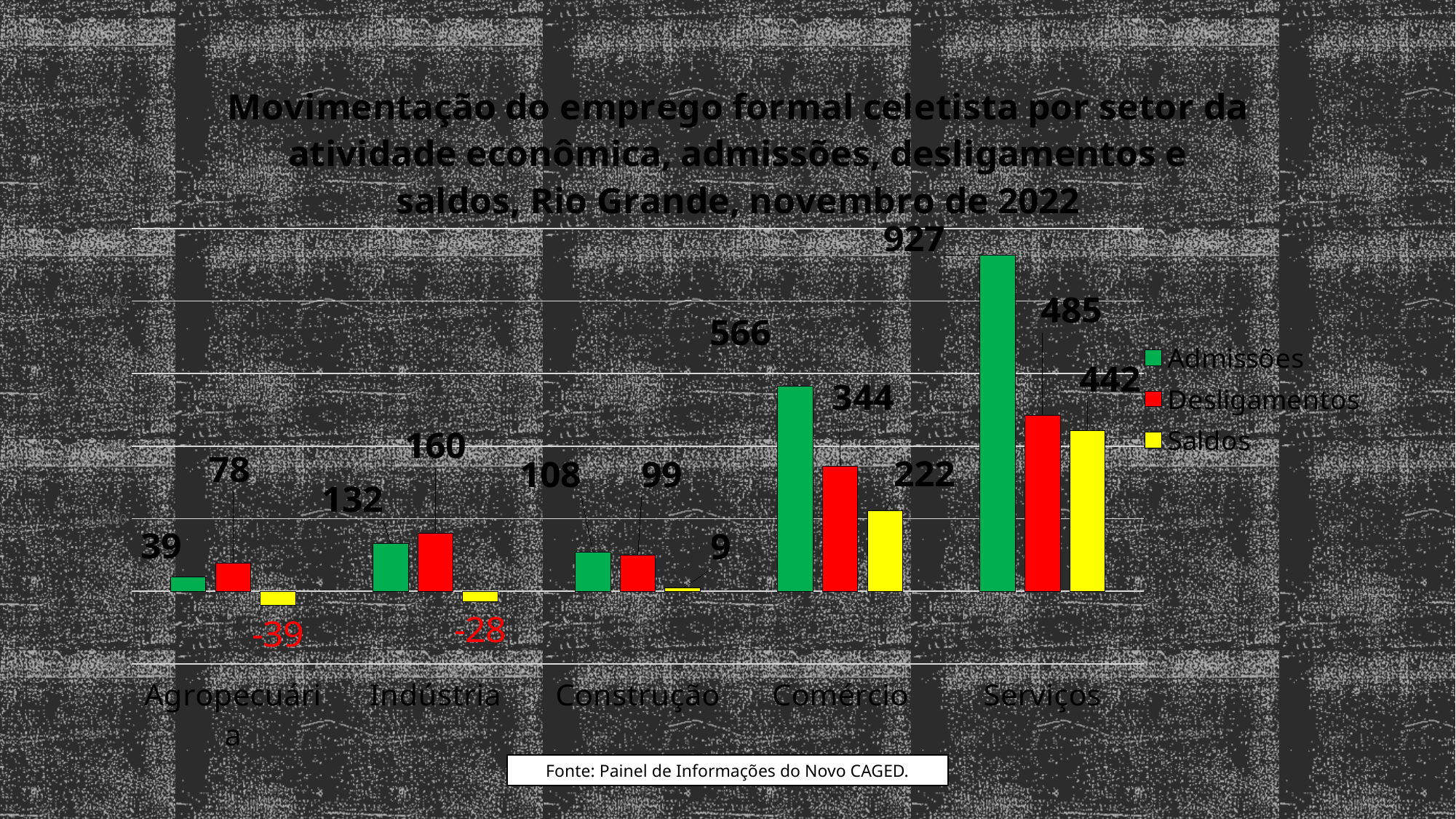
What is the value of Saldos for Agropecuária? -39 Which is larger for Indústria, Admissões or Desligamentos? Desligamentos What is the difference between Admissões and Desligamentos for Comércio? 222 Which sector has the highest value of Admissões? Serviços What is the value of Desligamentos for Comércio? 344 What kind of chart is shown on the slide? Bar chart Which sector has the lowest value of Saldos? Agropecuária How many sectors are shown on the x axis? 5 How many series does the legend list? 3 What is the value of Saldos for Construção? 9 What is the value of Admissões for Serviços? 927 Which colour represents the Saldos series? Yellow